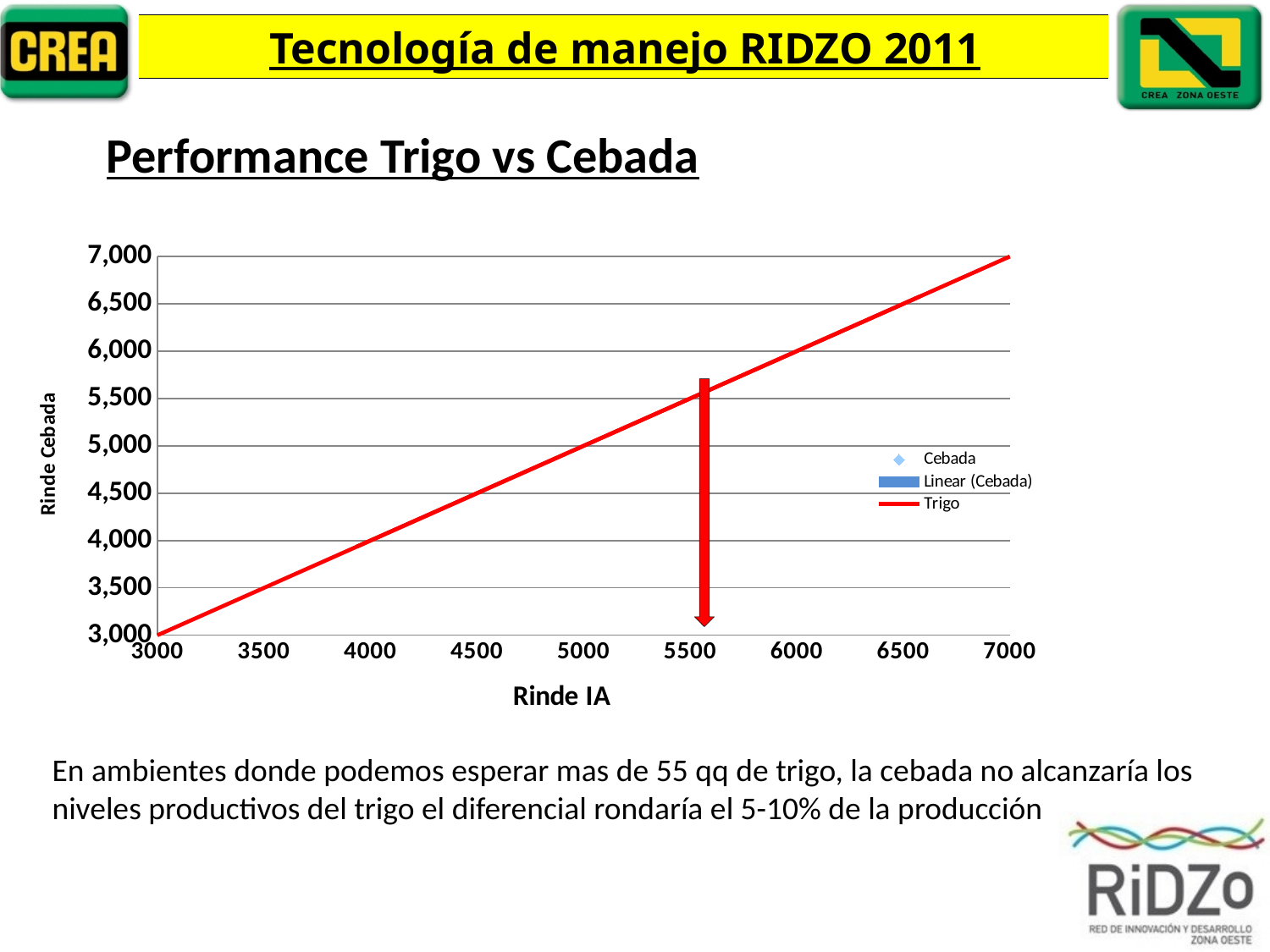
What is the highest value shown on the y axis of the chart? 7,000 What is the Trigo value at Rinde IA 7000? 7,000 Is the Trigo value at Rinde IA 4000 greater or less than 4,500? less Is the Trigo value at Rinde IA 6500 greater or less than 6,000? greater What is the Trigo value at Rinde IA 3000? 3,000 Is the Trigo value at Rinde IA 5000 greater or less than 4,500? greater Does the Trigo line rise or fall as Rinde IA increases? rises What kind of chart is shown on the slide? line chart What is the title of the y axis of the chart? Rinde Cebada How many tick labels are shown on the x axis of the chart? 9 How many series does the chart legend list? 3 What is the title of the x axis of the chart? Rinde IA